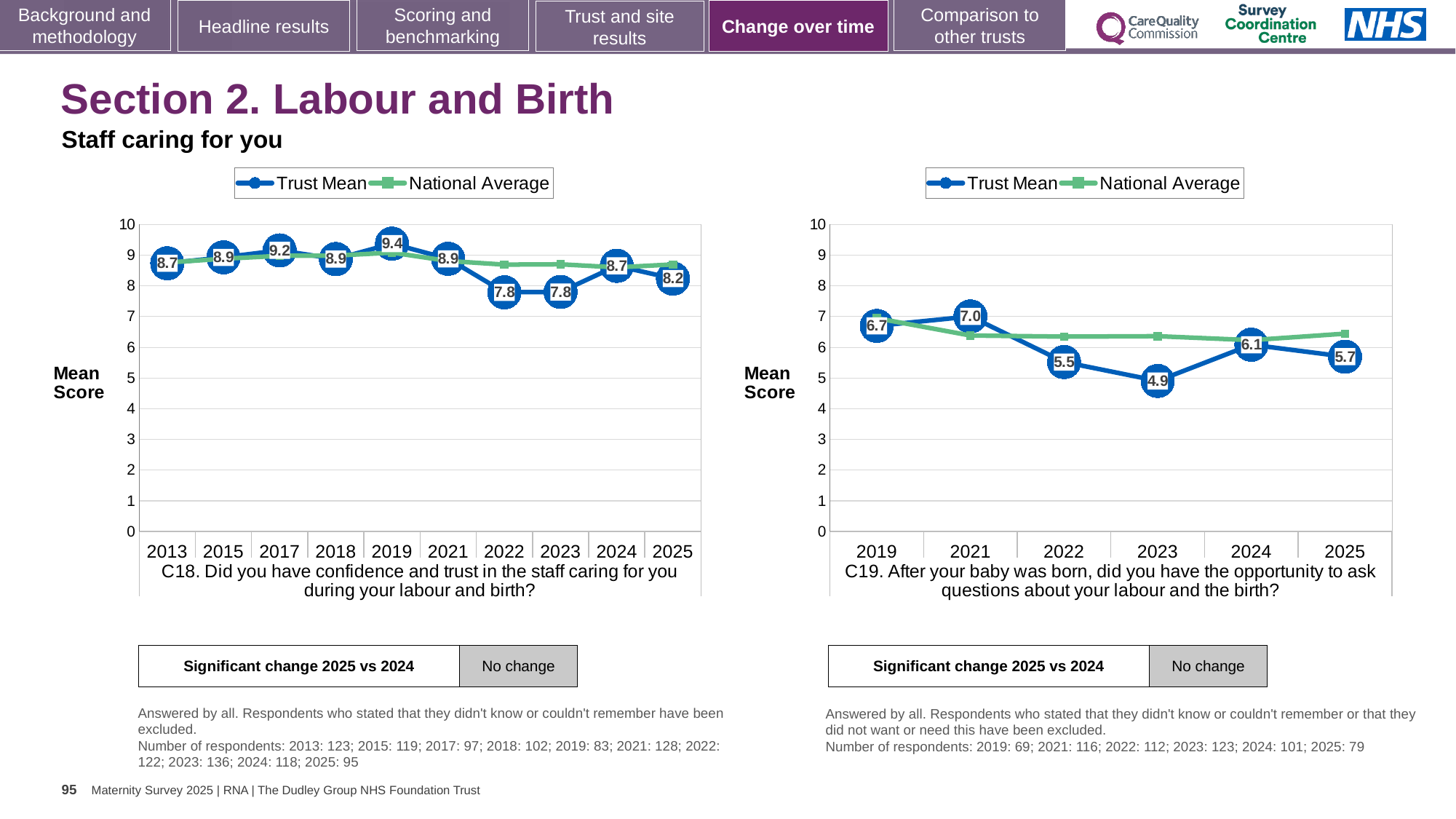
In the left chart (C18), which year has the lowest Trust Mean? 2022 and 2023 (7.8) What type of chart is used for C18 on the left? Line chart In the left chart (C18), what is the Trust Mean for 2019? 9.4 In the right chart (C19), which year has the highest Trust Mean? 2021 In the left chart (C18), what is the Trust Mean for 2025? 8.2 In the left chart (C18), how many years are plotted on the x axis? 10 How many series does the legend of the right chart (C19) list? 2 In the left chart (C18), is the National Average for 2022 greater or less than 8? greater In the right chart (C19), what is the Trust Mean for 2023? 4.9 In the left chart (C18), what is the difference between the Trust Mean in 2019 and in 2022? 1.6 In the right chart (C19), is the Trust Mean for 2024 larger or smaller than for 2025? larger In the right chart (C19), what is the difference between the Trust Mean in 2021 and in 2023? 2.1